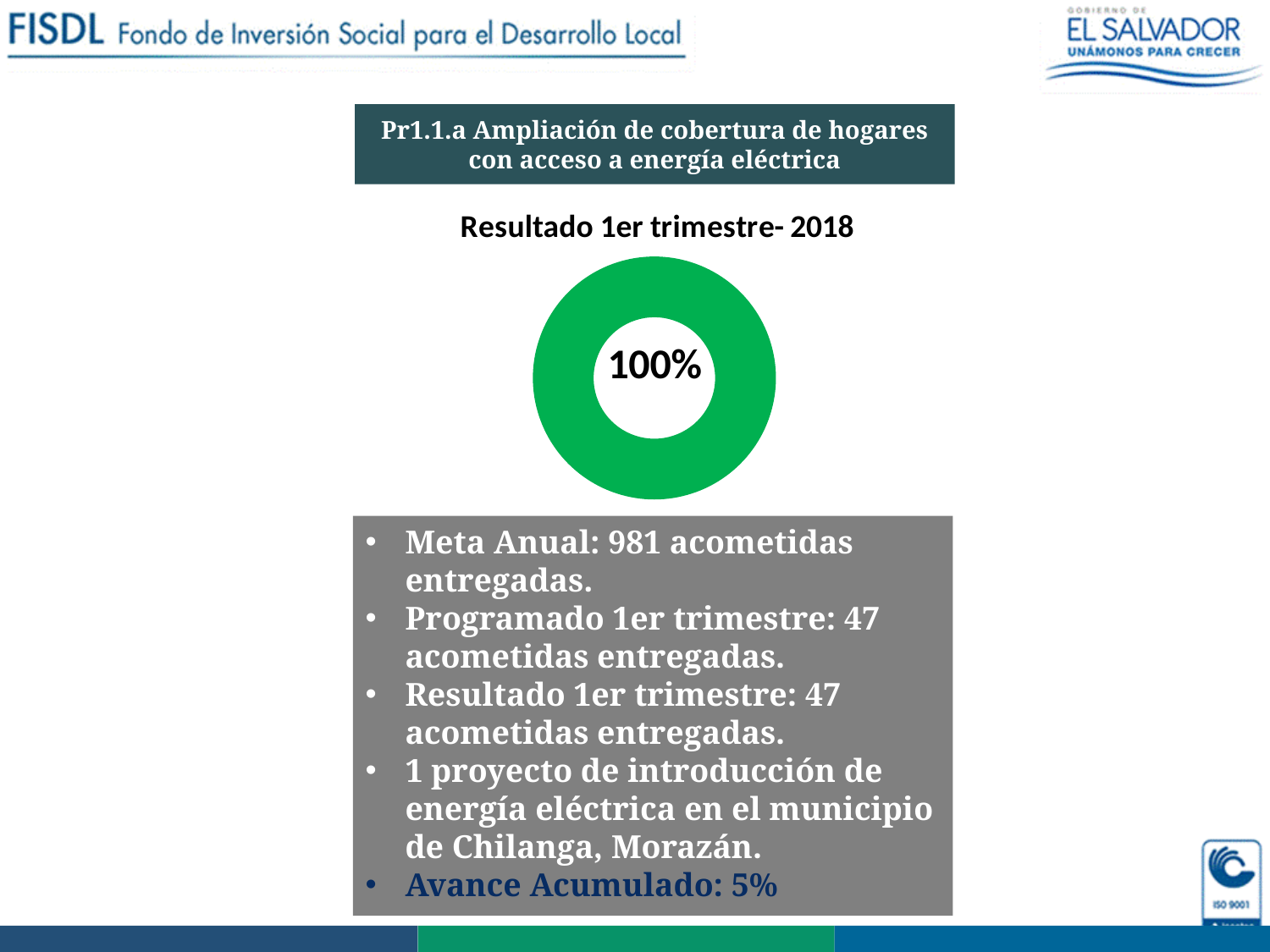
What is the title shown above the doughnut chart? Resultado 1er trimestre- 2018 What colour is the slice of the doughnut chart? green What kind of chart is shown on the slide? doughnut chart What share of the doughnut chart does the green slice represent? 100% Is the value shown in the doughnut chart greater or less than 50%? greater How many slices does the doughnut chart contain? 1 What value is printed in the centre of the doughnut chart? 100%